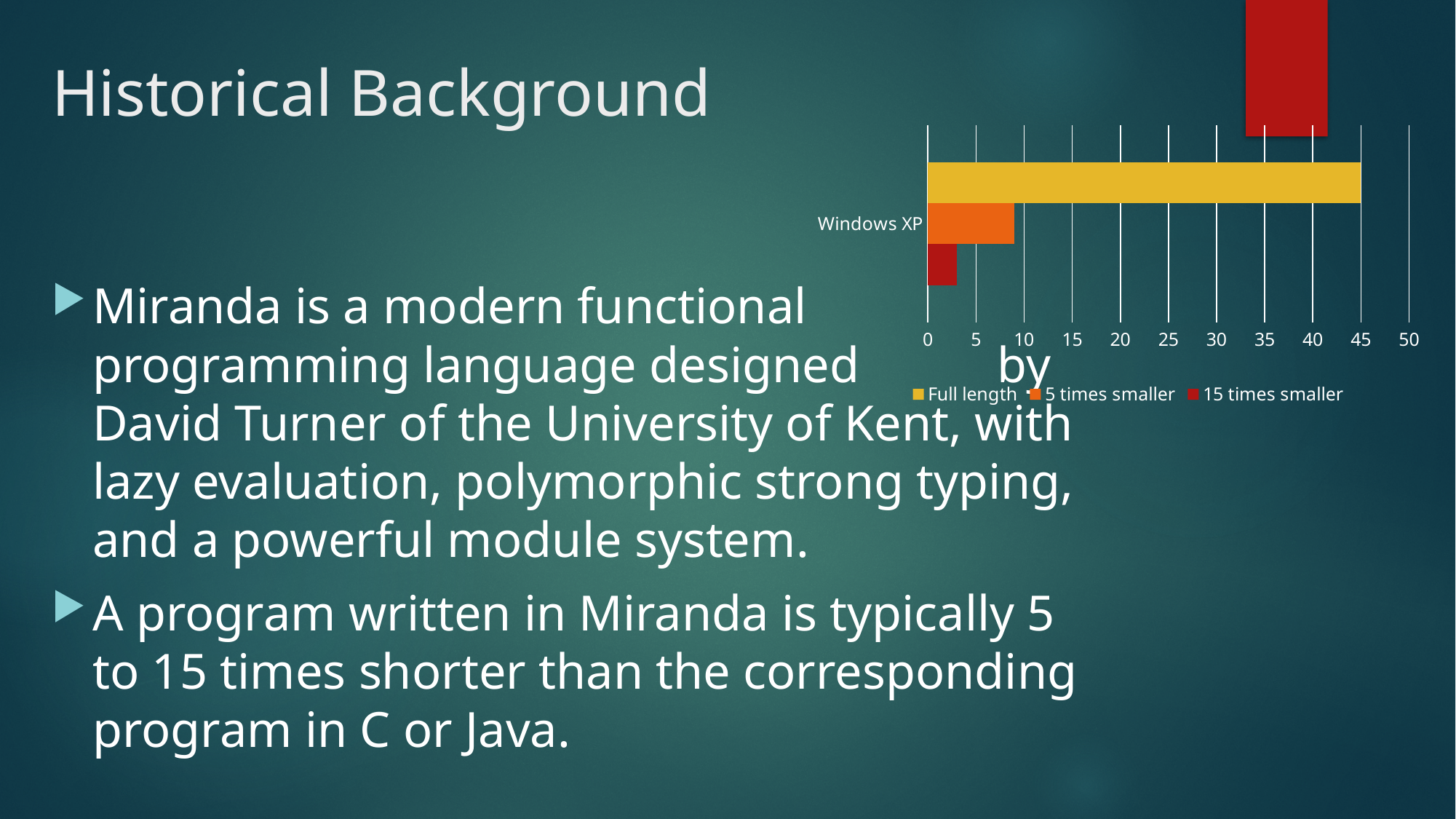
Which series has the longest bar for Windows XP? Full length Which series has the shortest bar for Windows XP? 15 times smaller How many categories are plotted on the chart? 1 What is the category label shown on the chart's vertical axis? Windows XP What are the three series named in the chart's legend? Full length, 5 times smaller, 15 times smaller What kind of chart is shown on the slide? bar chart What is the value of the Full length bar for Windows XP? 45 How many series does the chart's legend list? 3 Is the value for the 15 times smaller bar greater or less than 5? less Is the value for the Full length bar greater or less than 40? greater Is the value for the 5 times smaller bar greater or less than 10? less Which is larger for Windows XP, the 5 times smaller bar or the 15 times smaller bar? 5 times smaller